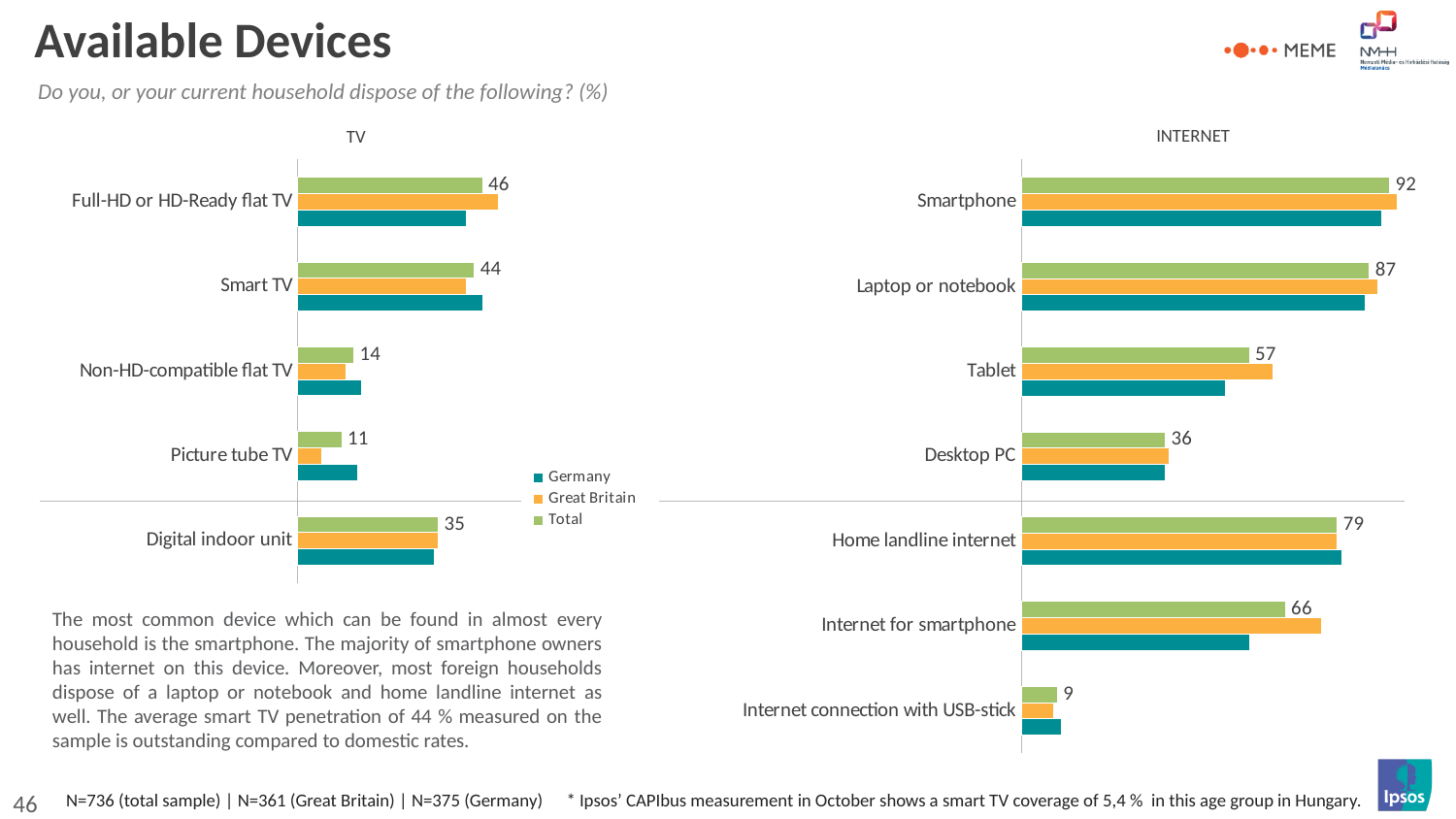
In the TV chart, which category has the lowest Total value? Picture tube TV In the TV chart, what is the difference between the Total values for Full-HD or HD-Ready flat TV and Digital indoor unit? 11 In the INTERNET chart, what is the Total value for Tablet? 57 How many categories does the INTERNET chart show? 7 In the INTERNET chart, for Tablet, is the Germany bar or the Great Britain bar longer? Great Britain In the INTERNET chart, what is the difference between the Total values for Smartphone and Laptop or notebook? 5 In the INTERNET chart, which category has the highest Total value? Smartphone How many series does the legend list? 3 In the TV chart, what is the Total value for Smart TV? 44 In the TV chart, for Smart TV, is the Germany bar or the Great Britain bar longer? Germany In the TV chart, which category has the highest Total value? Full-HD or HD-Ready flat TV In the INTERNET chart, what is the Total value for Internet connection with USB-stick? 9